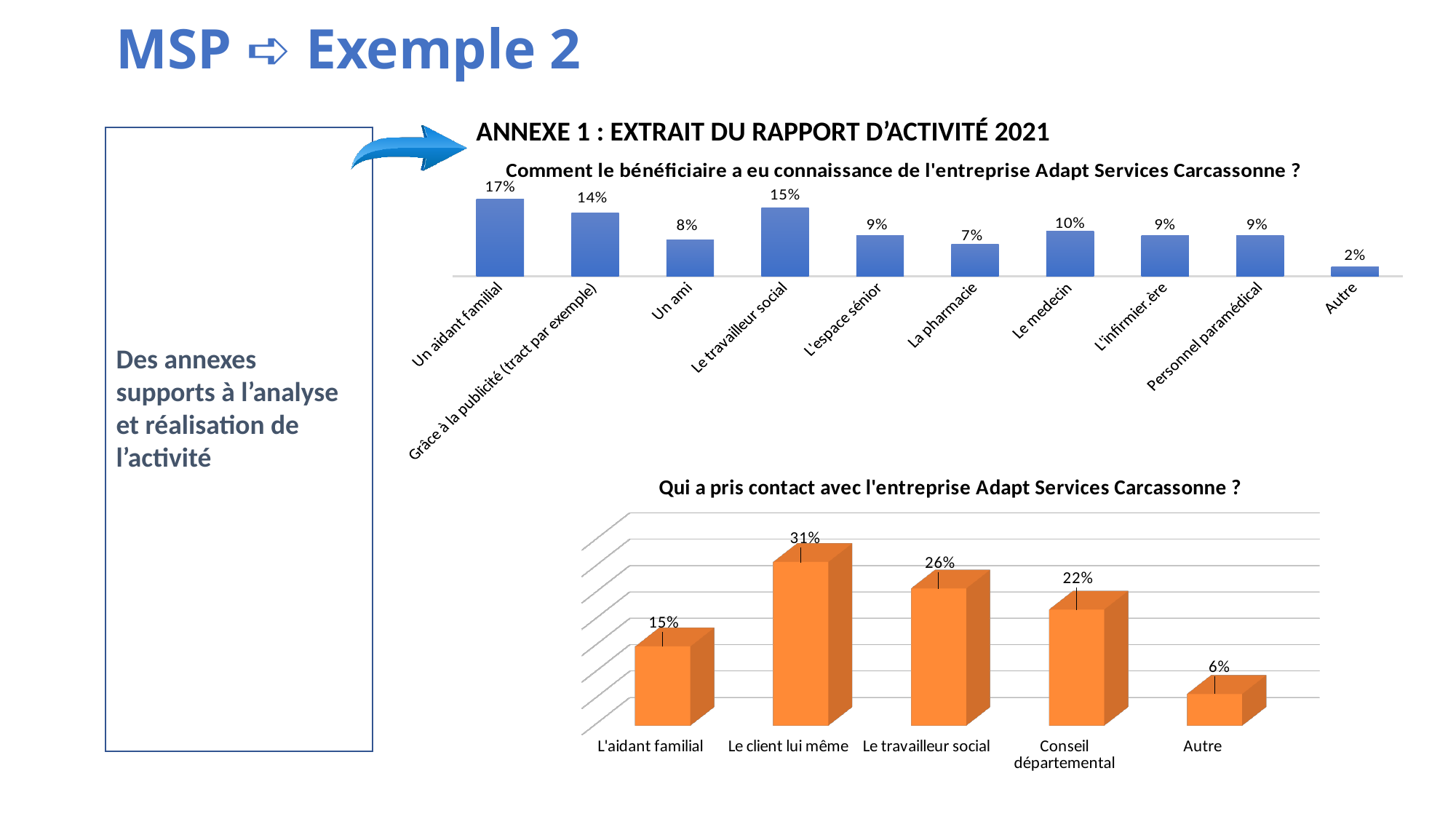
In the chart 'Qui a pris contact avec l'entreprise Adapt Services Carcassonne ?', how many categories are shown? 5 In the chart 'Comment le bénéficiaire a eu connaissance de l'entreprise Adapt Services Carcassonne ?', what is the value for 'Le medecin'? 10% In the chart 'Comment le bénéficiaire a eu connaissance de l'entreprise Adapt Services Carcassonne ?', which category has the highest value? Un aidant familial What kind of chart is 'Qui a pris contact avec l'entreprise Adapt Services Carcassonne ?'? Bar chart In the chart 'Qui a pris contact avec l'entreprise Adapt Services Carcassonne ?', which is larger: 'L'aidant familial' or 'Le travailleur social'? Le travailleur social In the chart 'Qui a pris contact avec l'entreprise Adapt Services Carcassonne ?', what is the value for 'Conseil départemental'? 22% In the chart 'Qui a pris contact avec l'entreprise Adapt Services Carcassonne ?', which category has the highest value? Le client lui même In the chart 'Comment le bénéficiaire a eu connaissance de l'entreprise Adapt Services Carcassonne ?', what is the difference between 'Le travailleur social' and 'La pharmacie'? 8% In the chart 'Comment le bénéficiaire a eu connaissance de l'entreprise Adapt Services Carcassonne ?', what is the value for 'Un aidant familial'? 17% In the chart 'Comment le bénéficiaire a eu connaissance de l'entreprise Adapt Services Carcassonne ?', which category has the lowest value? Autre In the chart 'Comment le bénéficiaire a eu connaissance de l'entreprise Adapt Services Carcassonne ?', how many categories are shown? 10 In the chart 'Qui a pris contact avec l'entreprise Adapt Services Carcassonne ?', what is the value for 'Le client lui même'? 31%